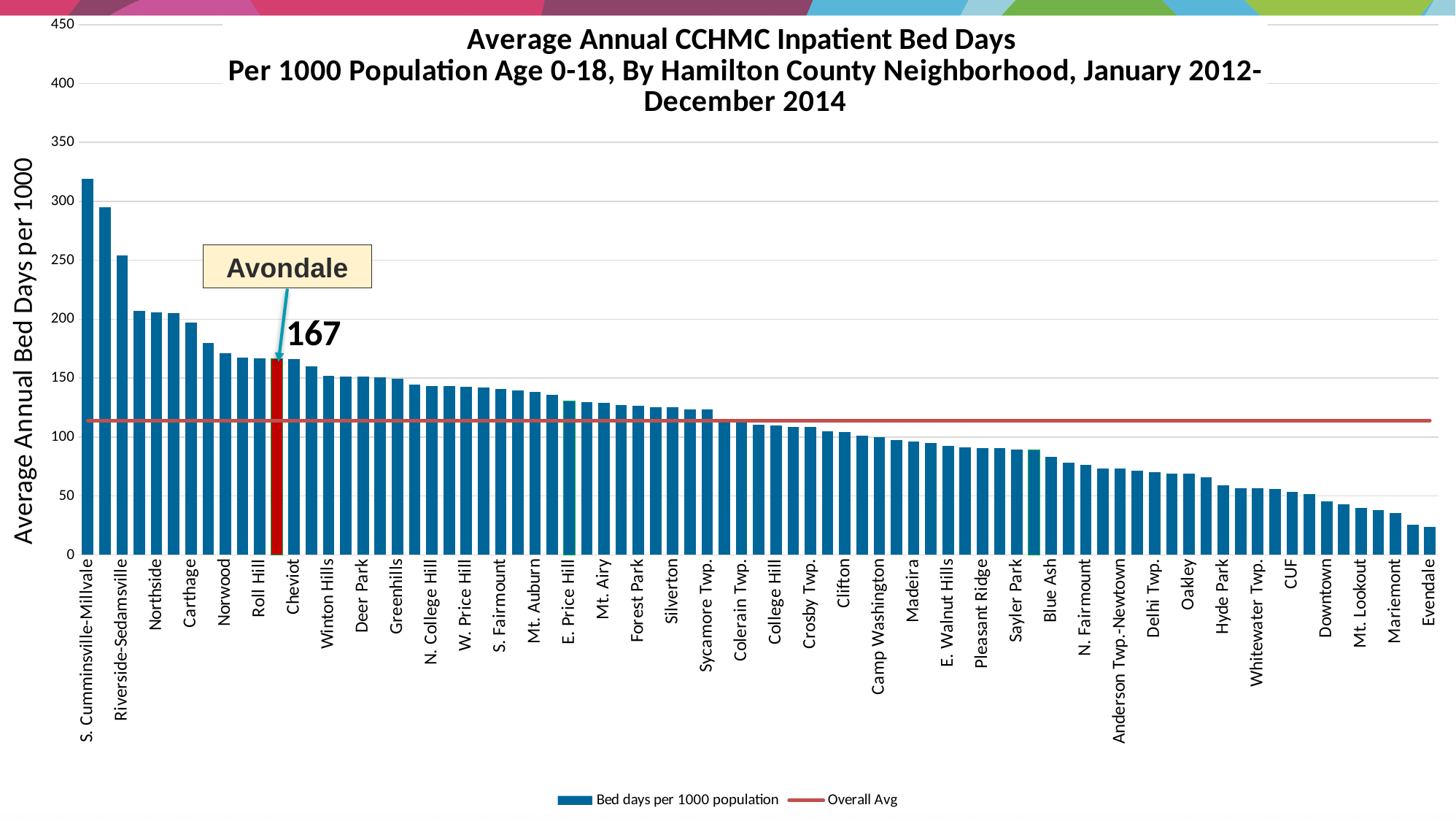
Which neighborhood has the highest average annual bed days per 1000? S. Cumminsville-Millvale What is the value for Avondale? 167 How many series does the legend list? 2 Do the bar values rise or fall from left to right across the neighborhoods? fall What is the label of the y axis? Average Annual Bed Days per 1000 What kind of chart is shown on the slide? combination bar and line chart Is the value for S. Cumminsville-Millvale greater or less than 300? greater Is the value for Evendale greater or less than 50? less Which has a higher value, Northside or Norwood? Northside Which neighborhood has the lowest average annual bed days per 1000? Evendale Is the value for Northside greater or less than 200? greater